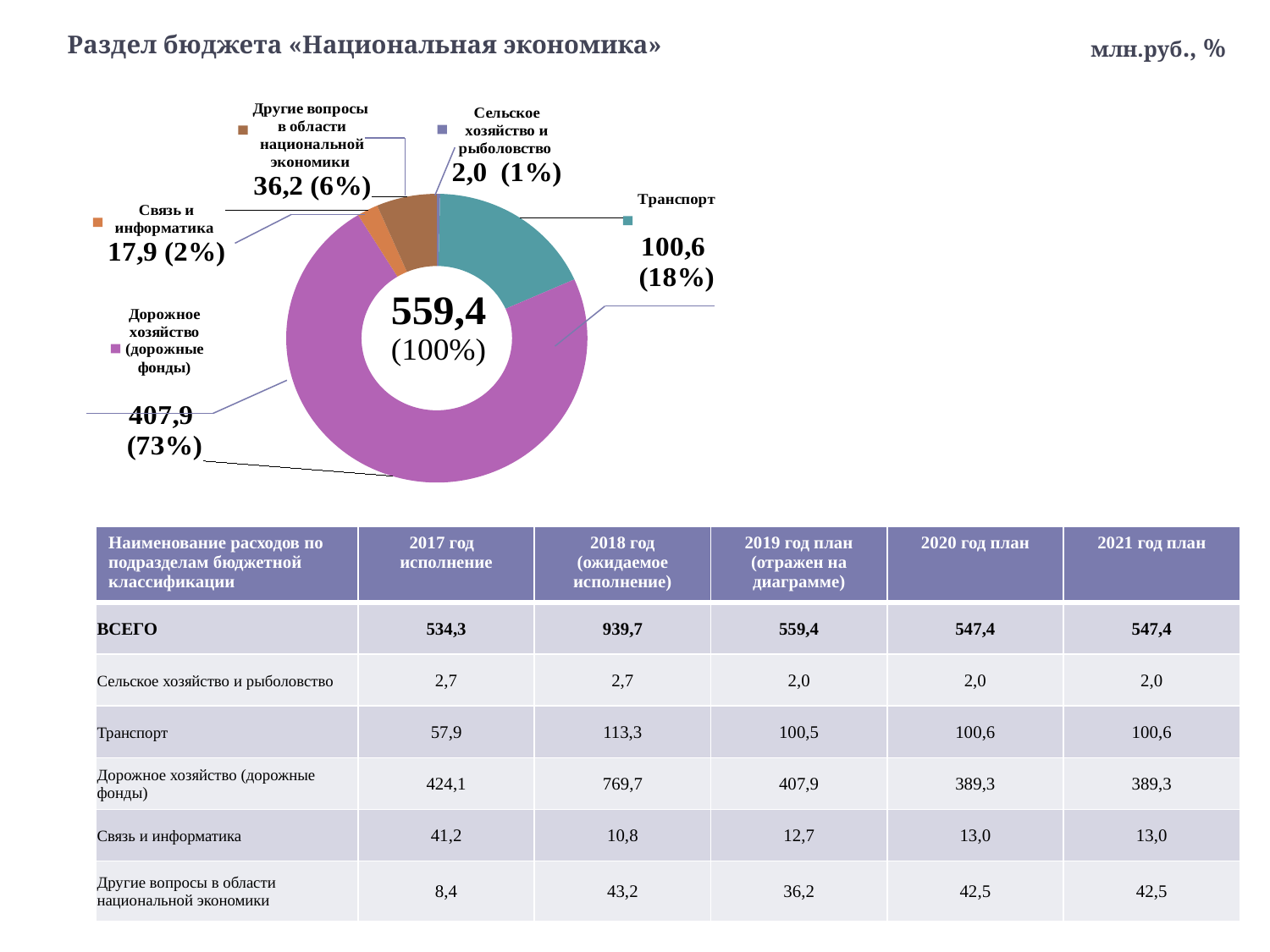
What value is shown for Дорожное хозяйство (дорожные фонды) on the chart? 407,9 What type of chart is shown on the slide? Doughnut (pie) chart What value is shown for Связь и информатика on the chart? 17,9 What value is shown for Другие вопросы в области национальной экономики on the chart? 36,2 What share of the chart does Сельское хозяйство и рыболовство represent? 1% Which category has the largest slice of the chart? Дорожное хозяйство (дорожные фонды) What share of the chart does Транспорт represent? 18% Which category has the smallest slice of the chart? Сельское хозяйство и рыболовство What total value is shown in the centre of the chart? 559,4 What value is shown for Транспорт on the chart? 100,6 Which is larger on the chart, Другие вопросы в области национальной экономики or Связь и информатика? Другие вопросы в области национальной экономики How many categories are shown in the chart? 5